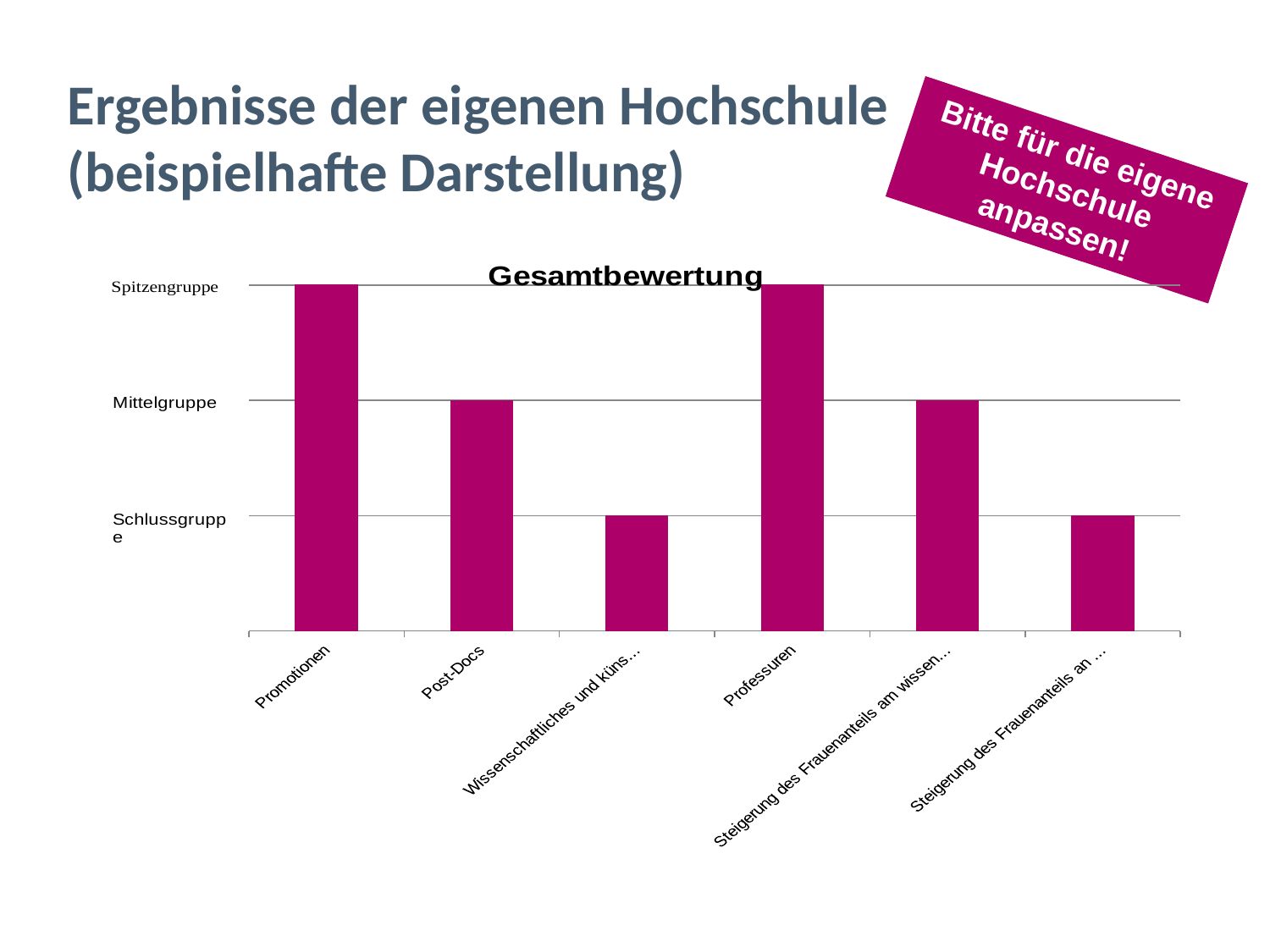
What type of chart is shown on the slide? bar chart Which is rated higher, Promotionen or Post-Docs? Promotionen How many categories (bars) does the chart show? 6 Which group level does the bar for Post-Docs reach? Mittelgruppe Which is rated higher, Post-Docs or Professuren? Professuren Which group level does the rightmost bar (Steigerung des Frauenanteils an ...) reach? Schlussgruppe Which group level does the bar for Professuren reach? Spitzengruppe Which group level does the third bar from the left (Wissenschaftliches und küns...) reach? Schlussgruppe Which group level does the bar for Promotionen reach? Spitzengruppe How many rating levels are labelled on the vertical axis? 3 What is the title of the chart? Gesamtbewertung Which is rated lower, Post-Docs or the rightmost bar (Steigerung des Frauenanteils an ...)? Steigerung des Frauenanteils an ...